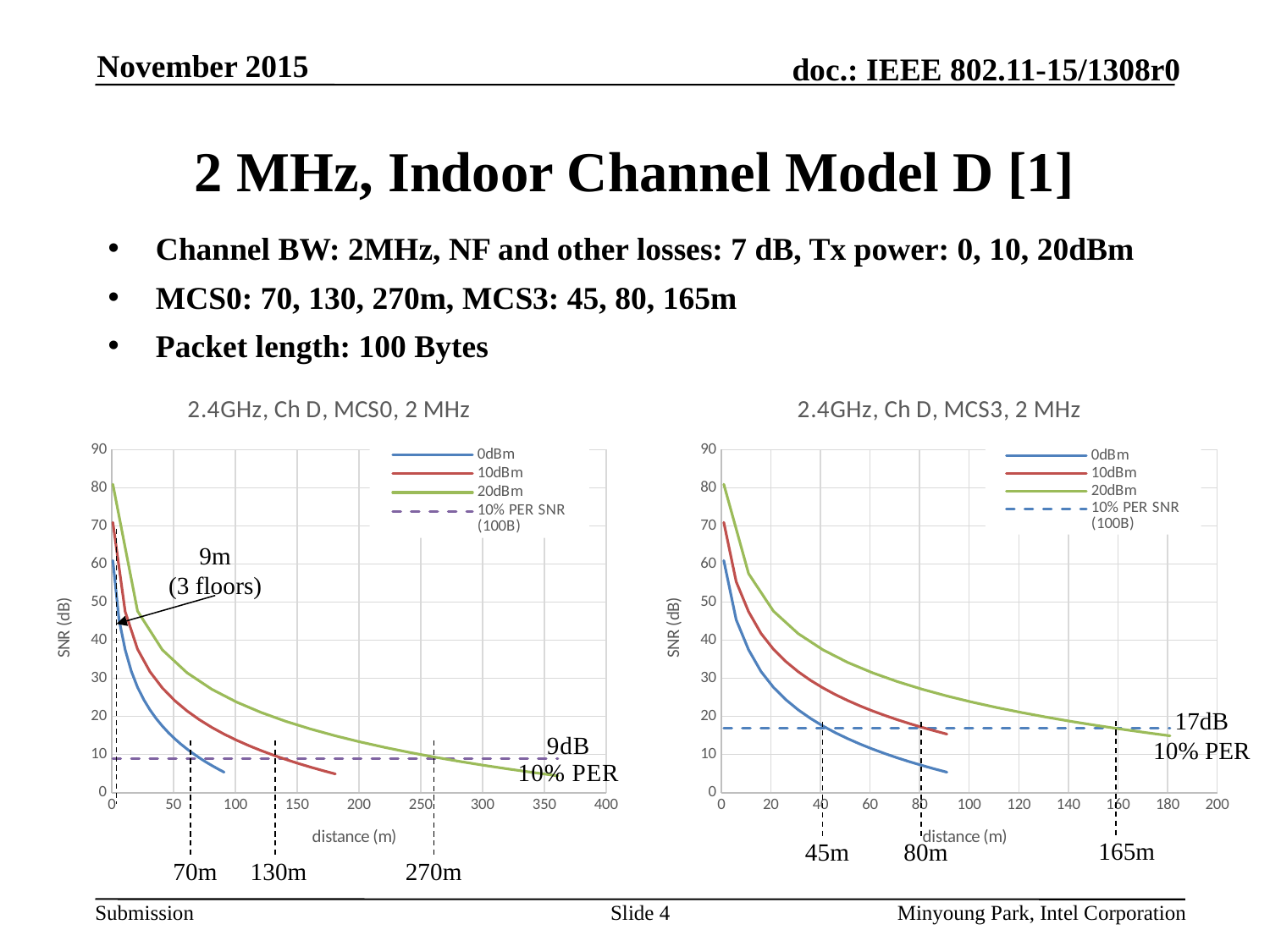
How many entries does the legend of the right chart (2.4GHz, Ch D, MCS3, 2 MHz) list? 4 In the left chart (MCS0), at what distance does the 0dBm curve cross the 10% PER SNR line, as annotated? 70m In the right chart (MCS3), which Tx power series has the highest SNR at 100 m? 20dBm In the left chart (MCS0), does SNR rise or fall as distance increases? fall In the left chart (MCS0), at what distance does the 20dBm curve cross the 10% PER SNR line, as annotated? 270m In the right chart (MCS3), how much farther is the annotated 20dBm crossing distance (165m) than the 0dBm crossing distance (45m)? 120m In the right chart (MCS3), at what distance does the 10dBm curve cross the 10% PER SNR line, as annotated? 80m In the left chart (MCS0), what is the 10% PER SNR threshold marked on the dashed line? 9dB In the right chart (MCS3), what is the 10% PER SNR threshold marked on the dashed line? 17dB In the left chart (MCS0), is the SNR of the 0dBm series at 50 m greater or less than 20? less What kind of chart is the left chart titled '2.4GHz, Ch D, MCS0, 2 MHz'? line chart What is the title of the right chart? 2.4GHz, Ch D, MCS3, 2 MHz